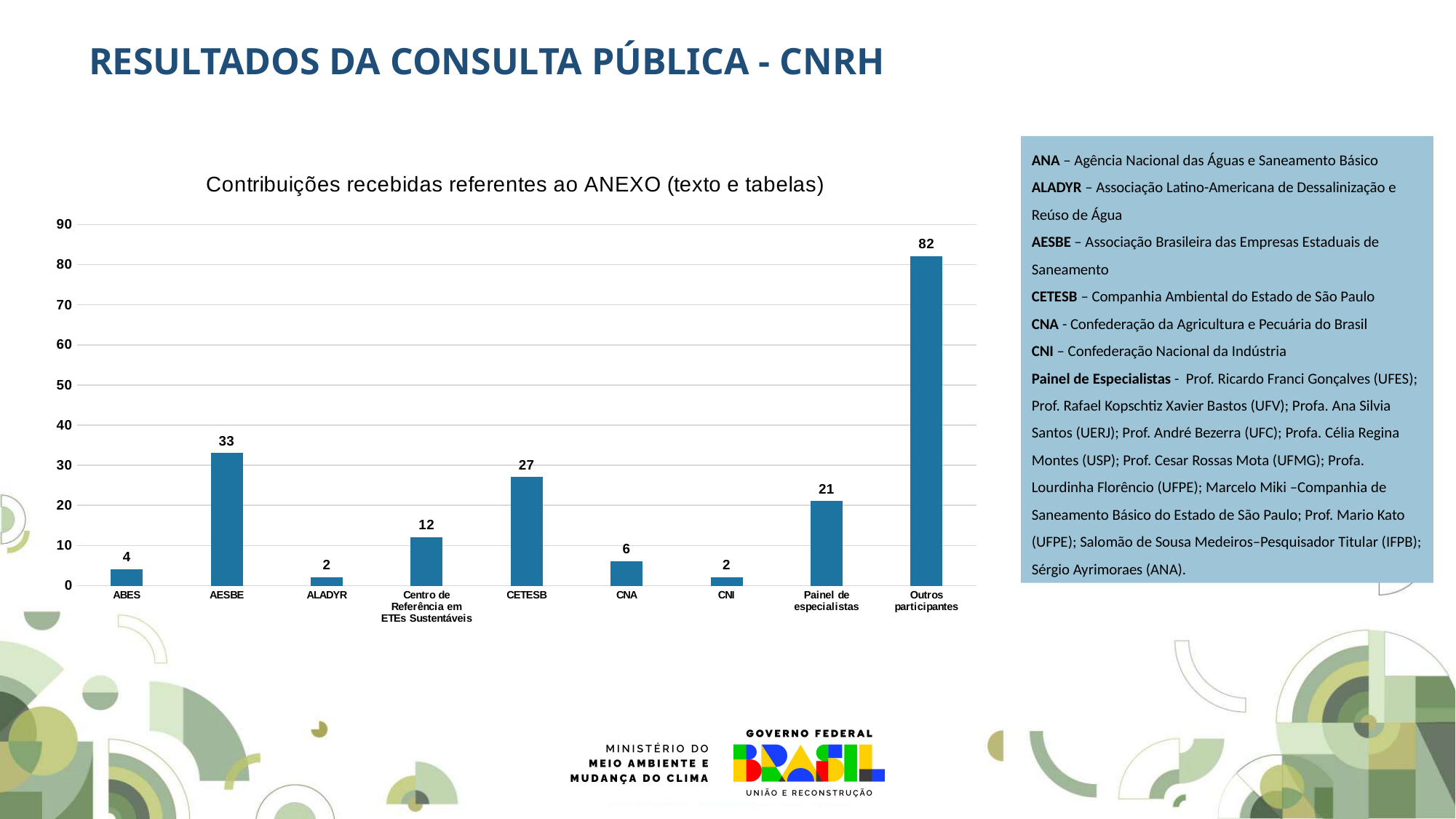
What is the value for Centro de Referência em ETEs Sustentáveis? 12 Which is larger, the value for CETESB or the value for CNA? CETESB Which category has the highest value? Outros participantes What is the title of the chart? Contribuições recebidas referentes ao ANEXO (texto e tabelas) What is the value for AESBE? 33 What is the difference between the values for Outros participantes and AESBE? 49 Which categories share the lowest value of 2? ALADYR and CNI Is the value for CETESB greater or less than 30? less What kind of chart is shown? bar chart What is the difference between the values for CETESB and CNI? 25 How many categories are shown on the x axis? 9 What is the value for Painel de especialistas? 21